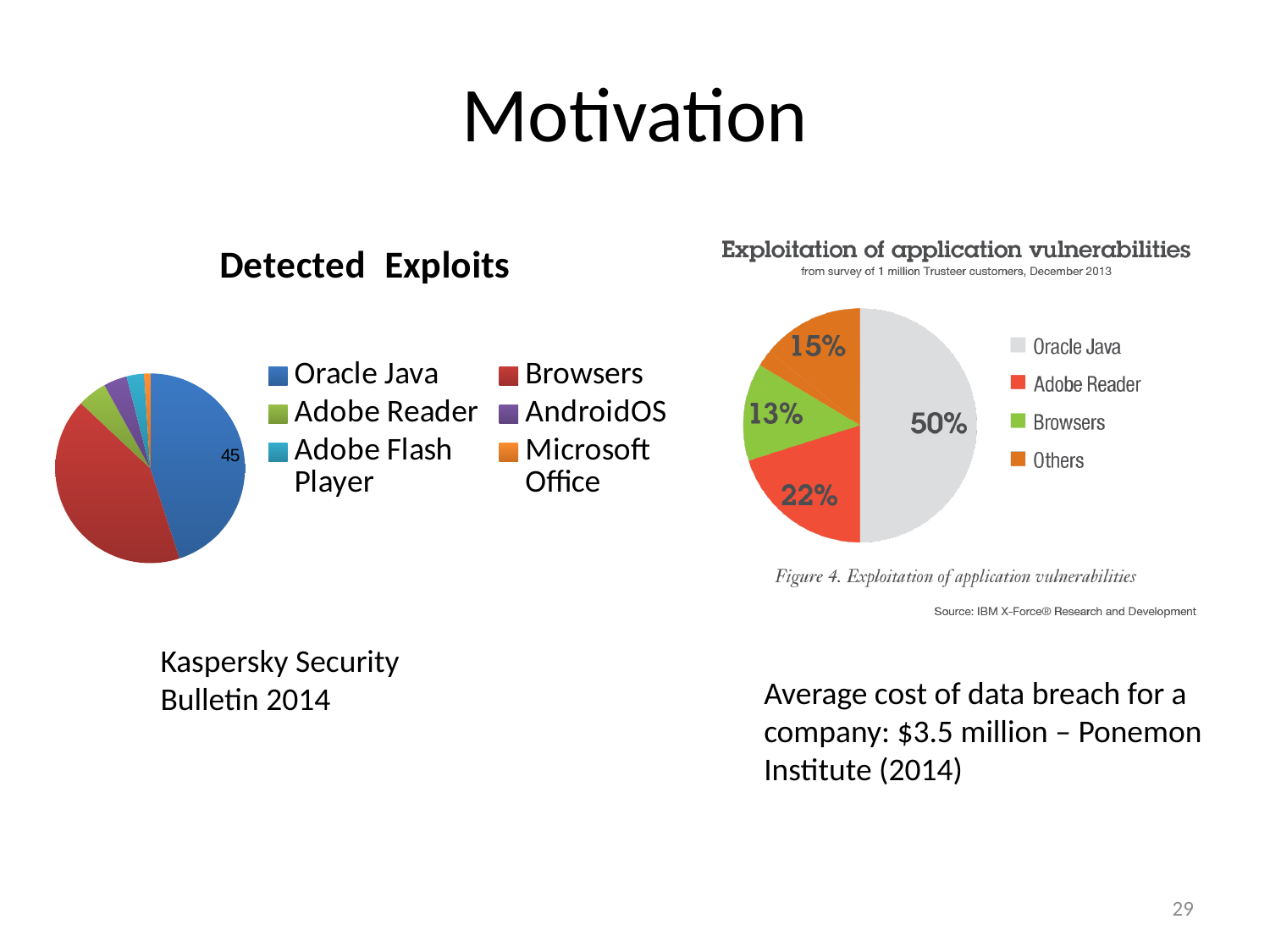
In the "Exploitation of application vulnerabilities" chart, what share does Oracle Java have? 50% In the "Exploitation of application vulnerabilities" chart, what is the difference between the Oracle Java and Adobe Reader shares? 28% In the "Exploitation of application vulnerabilities" chart, what is the value for Others? 15% In the "Detected Exploits" chart, which category has the smallest slice? Microsoft Office In the "Exploitation of application vulnerabilities" chart, which category has the largest share? Oracle Java What kind of chart is the "Detected Exploits" chart on the left? pie chart How many categories are shown in the "Exploitation of application vulnerabilities" pie chart? 4 How many categories does the legend of the "Detected Exploits" chart list? 6 In the "Exploitation of application vulnerabilities" chart, which category has the smallest share? Browsers In the "Exploitation of application vulnerabilities" chart, what is the value for Adobe Reader? 22% In the "Detected Exploits" chart, which slice is larger: Oracle Java or Adobe Reader? Oracle Java In the "Detected Exploits" chart, what value is labelled on the Oracle Java slice? 45